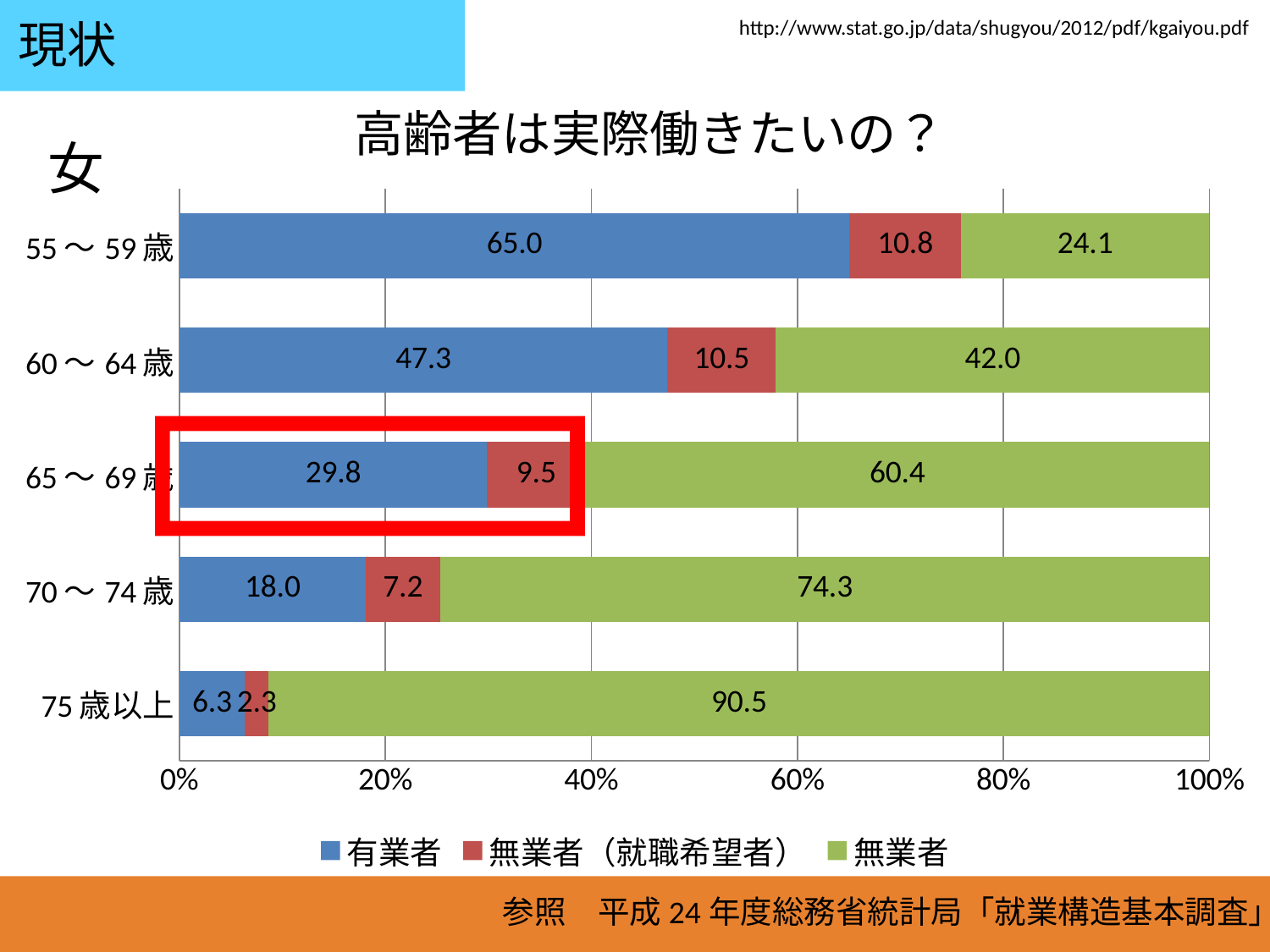
What is the value of 無業者 for the 65～69歳 group? 60.4 What is the difference between the 有業者 values for 55～59歳 and 60～64歳? 17.7 For the 60～64歳 group, which is larger: 有業者 or 無業者? 有業者 Does the value of 有業者 rise or fall as the age group gets older? Fall How many series does the legend list? 3 What is the value of 有業者 for the 55～59歳 group? 65.0 What is the difference between the 無業者 values for 75歳以上 and 70～74歳? 16.2 What kind of chart is shown on the slide? Stacked bar chart What is the value of 無業者（就職希望者） for the 70～74歳 group? 7.2 Which age group has the lowest value for 有業者? 75歳以上 Which age group has the highest value for 無業者? 75歳以上 How many age groups are shown in the chart? 5